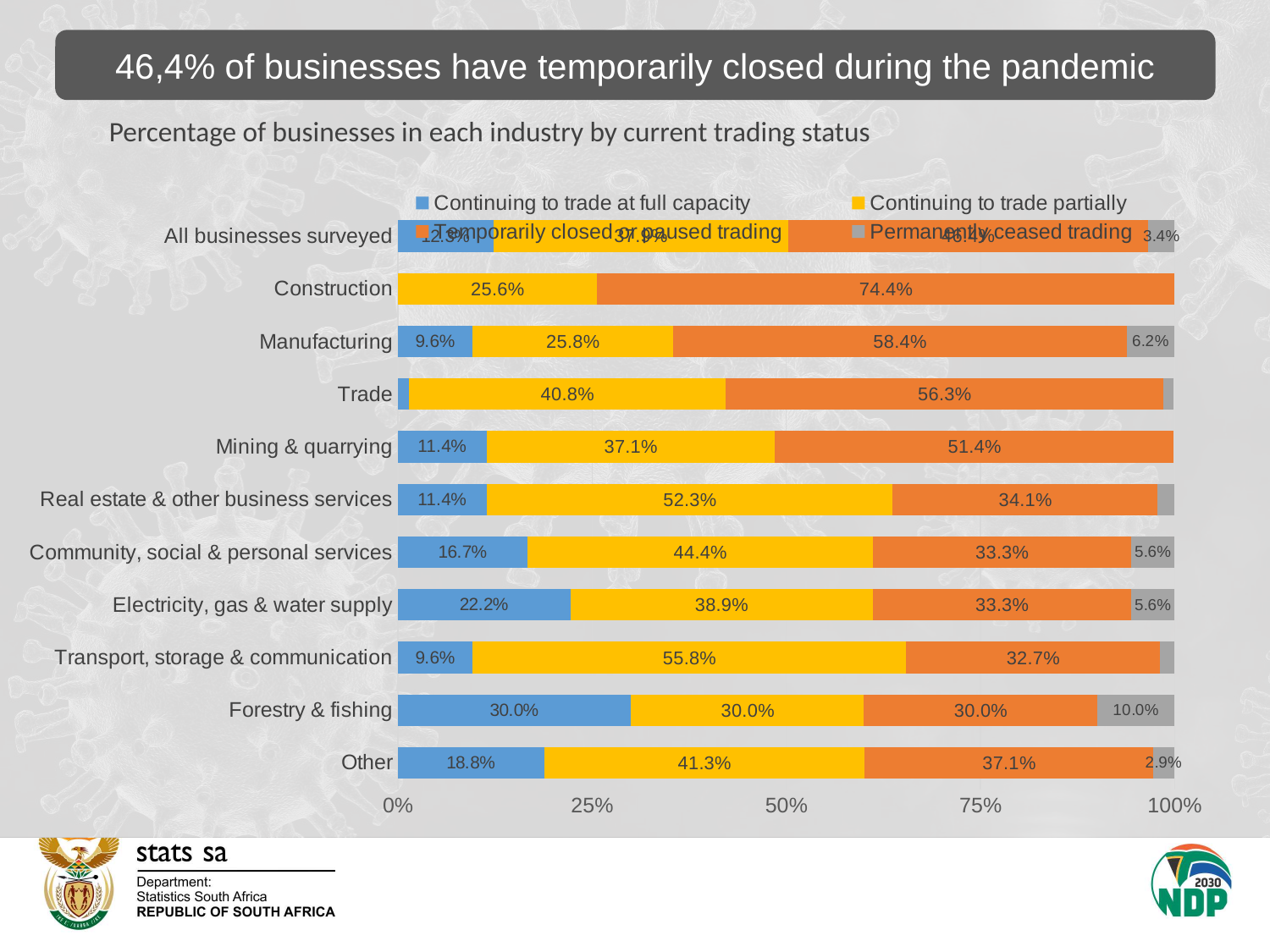
Which is larger: the percentage of Real estate & other business services businesses continuing to trade partially, or the percentage of Mining & quarrying businesses continuing to trade partially? Real estate & other business services What is the difference between the percentage of Transport, storage & communication businesses continuing to trade partially and those temporarily closed or paused trading? 23.1% How many industry categories are shown on the chart, including 'All businesses surveyed'? 11 Which industry has the highest percentage of businesses continuing to trade at full capacity? Forestry & fishing What percentage of Manufacturing businesses were continuing to trade at full capacity? 9.6% What percentage of Construction businesses were temporarily closed or paused trading? 74.4% Which industry has the highest percentage of businesses temporarily closed or paused trading? Construction How many series does the legend list? 4 What percentage of Forestry & fishing businesses had permanently ceased trading? 10.0% Is the percentage of Trade businesses temporarily closed or paused trading greater or less than 50%? greater What kind of chart is shown on the slide? Stacked bar chart Which colour represents 'Continuing to trade partially' in the chart? Yellow